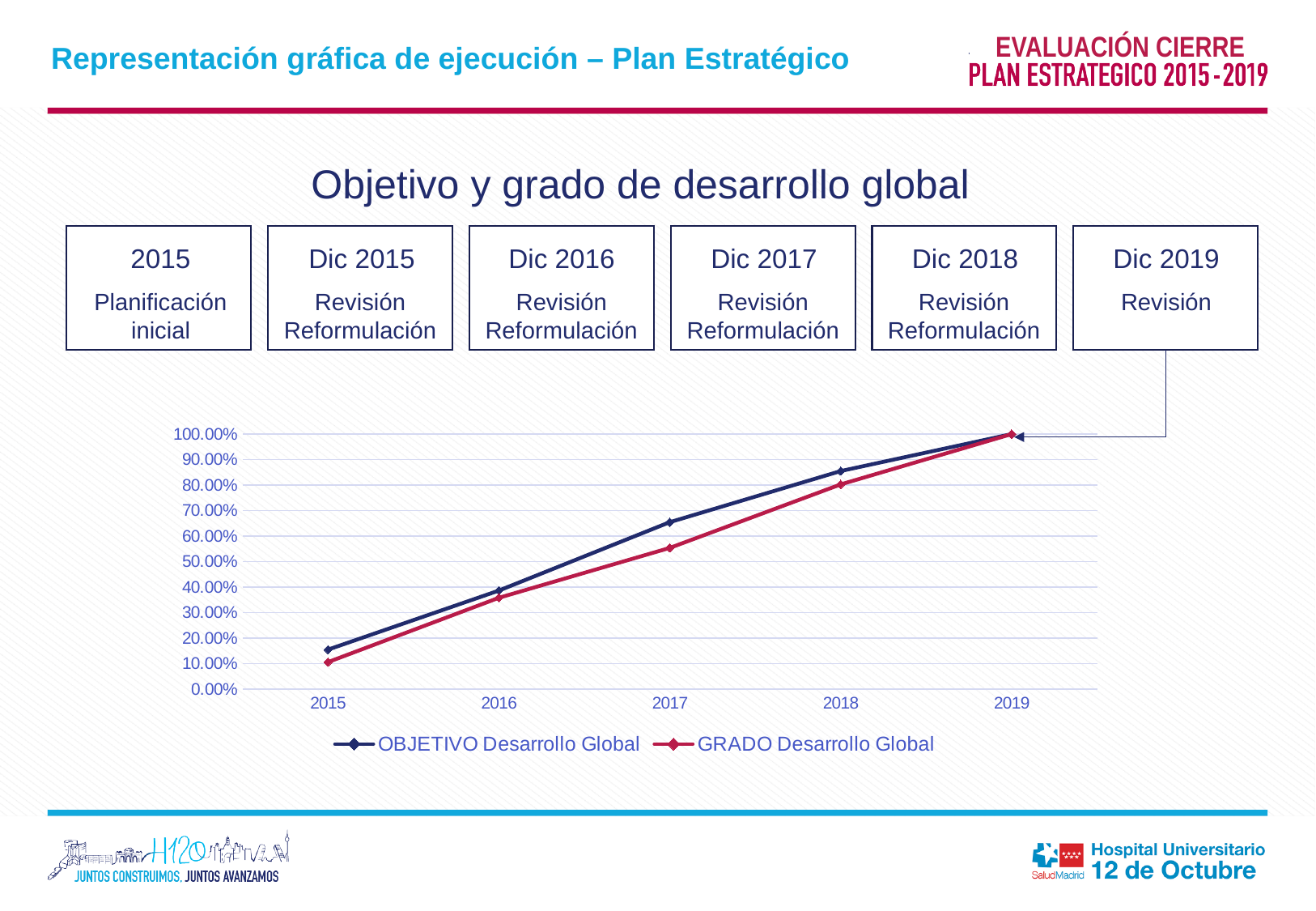
What is the value of OBJETIVO Desarrollo Global in 2019? 100.00% Is the value for GRADO Desarrollo Global in 2017 greater or less than 60.00%? less How many series does the chart legend list? 2 Do the values of GRADO Desarrollo Global rise or fall from 2015 to 2019? Rise What is the title of the chart? Objetivo y grado de desarrollo global In 2017, which series has the higher value, OBJETIVO Desarrollo Global or GRADO Desarrollo Global? OBJETIVO Desarrollo Global Is the value for OBJETIVO Desarrollo Global in 2018 greater or less than 80.00%? greater What kind of chart is shown on the slide? Line chart Is the value for OBJETIVO Desarrollo Global in 2017 greater or less than 60.00%? greater What is the value of GRADO Desarrollo Global in 2019? 100.00% How many years are plotted along the x axis of the chart? 5